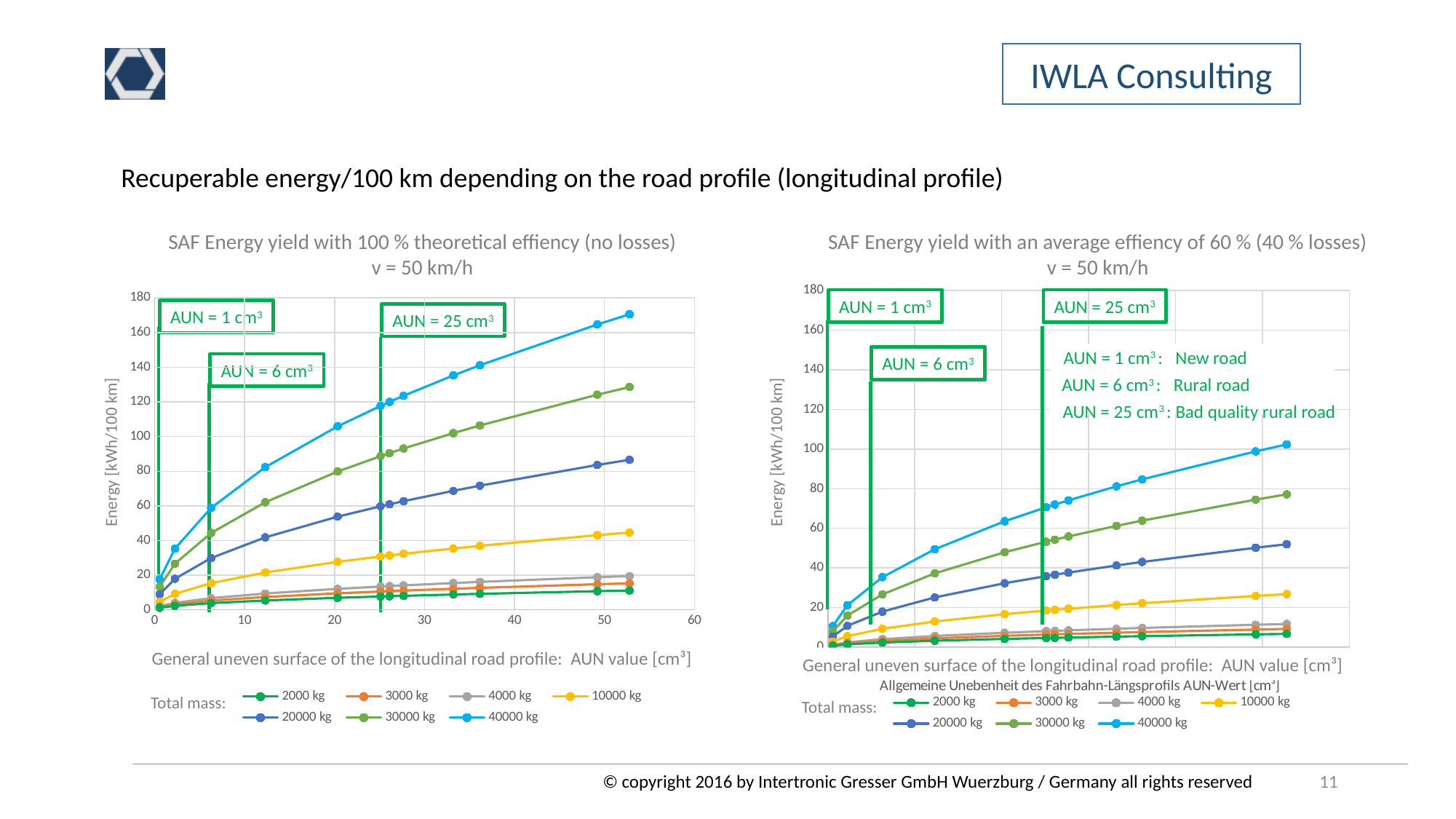
How many series does the legend of the left chart list? 7 In the right chart, is the energy value for the 30000 kg series at its rightmost point greater or less than 80? less What is the y-axis label of the right chart? Energy [kWh/100 km] What type of chart is the left chart, 'SAF Energy yield with 100 % theoretical effiency (no losses)'? line chart In the right chart, at the rightmost AUN value, which series is larger: 40000 kg or 30000 kg? 40000 kg In the left chart, is the energy value for the 40000 kg series at its rightmost point greater or less than 160? greater According to the annotation on the right chart, which road type corresponds to AUN = 25 cm³? Bad quality rural road In the left chart, do the energy values rise or fall as the AUN value increases along the x axis? rise In the left chart, is the energy value for the 20000 kg series at its rightmost point greater or less than 80? greater In the left chart (100 % theoretical efficiency), which total mass series has the highest energy values? 40000 kg In the right chart (average efficiency of 60 %), which total mass series has the lowest energy values? 2000 kg